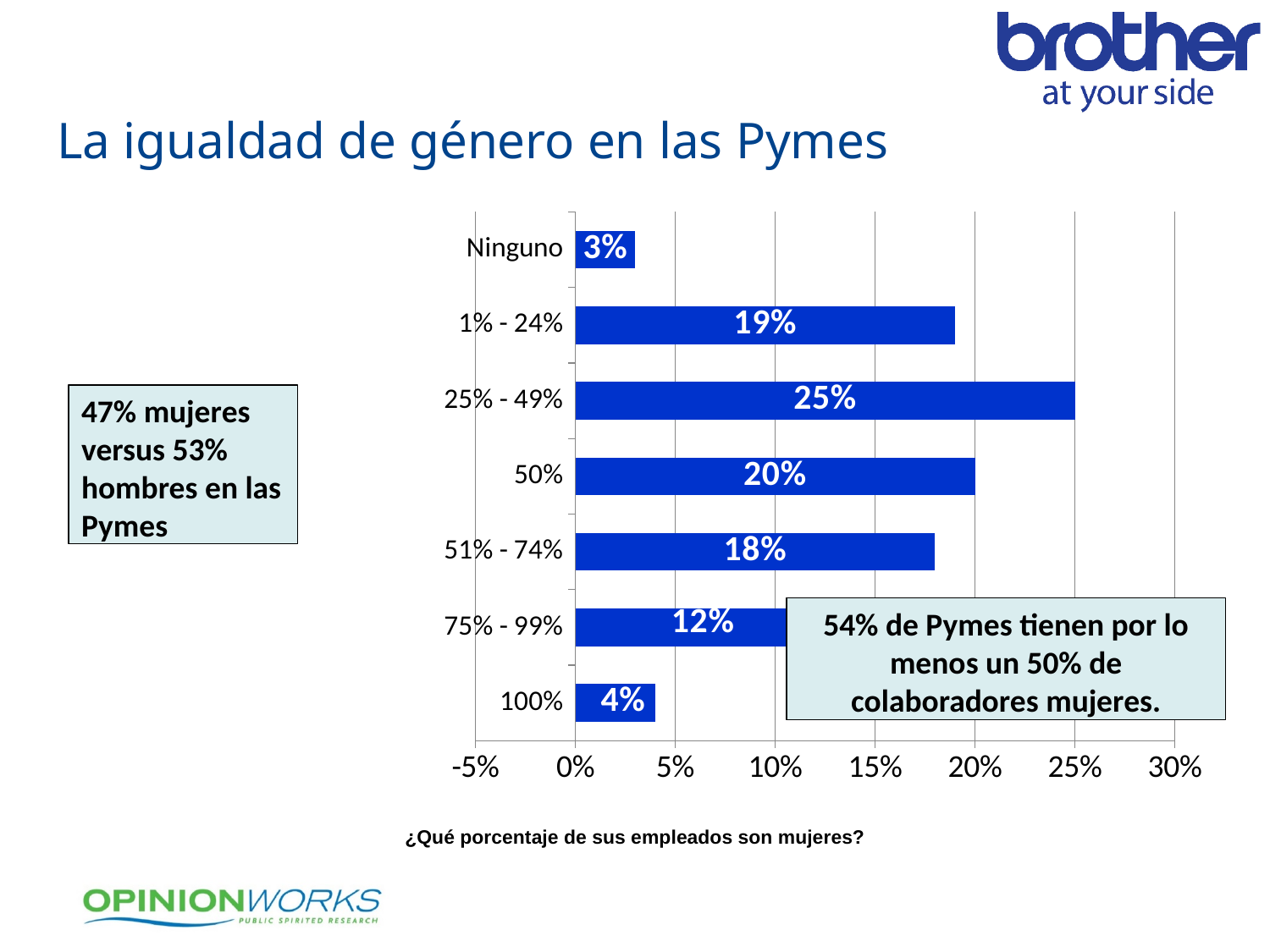
What is the value for the '75% - 99%' category? 12% How many categories are shown in the chart? 7 What is the value for the '25% - 49%' category? 25% What is the value for the 'Ninguno' category? 3% Which is larger, the value for '1% - 24%' or the value for '50%'? 50% What is the difference between the values for '50%' and '51% - 74%'? 2% Which category has the lowest value? Ninguno What question is written below the chart? ¿Qué porcentaje de sus empleados son mujeres? Which category has the highest value? 25% - 49% Is the value for '51% - 74%' greater or less than 15%? greater What is the value for the '100%' category? 4% What kind of chart is shown on the slide? Bar chart